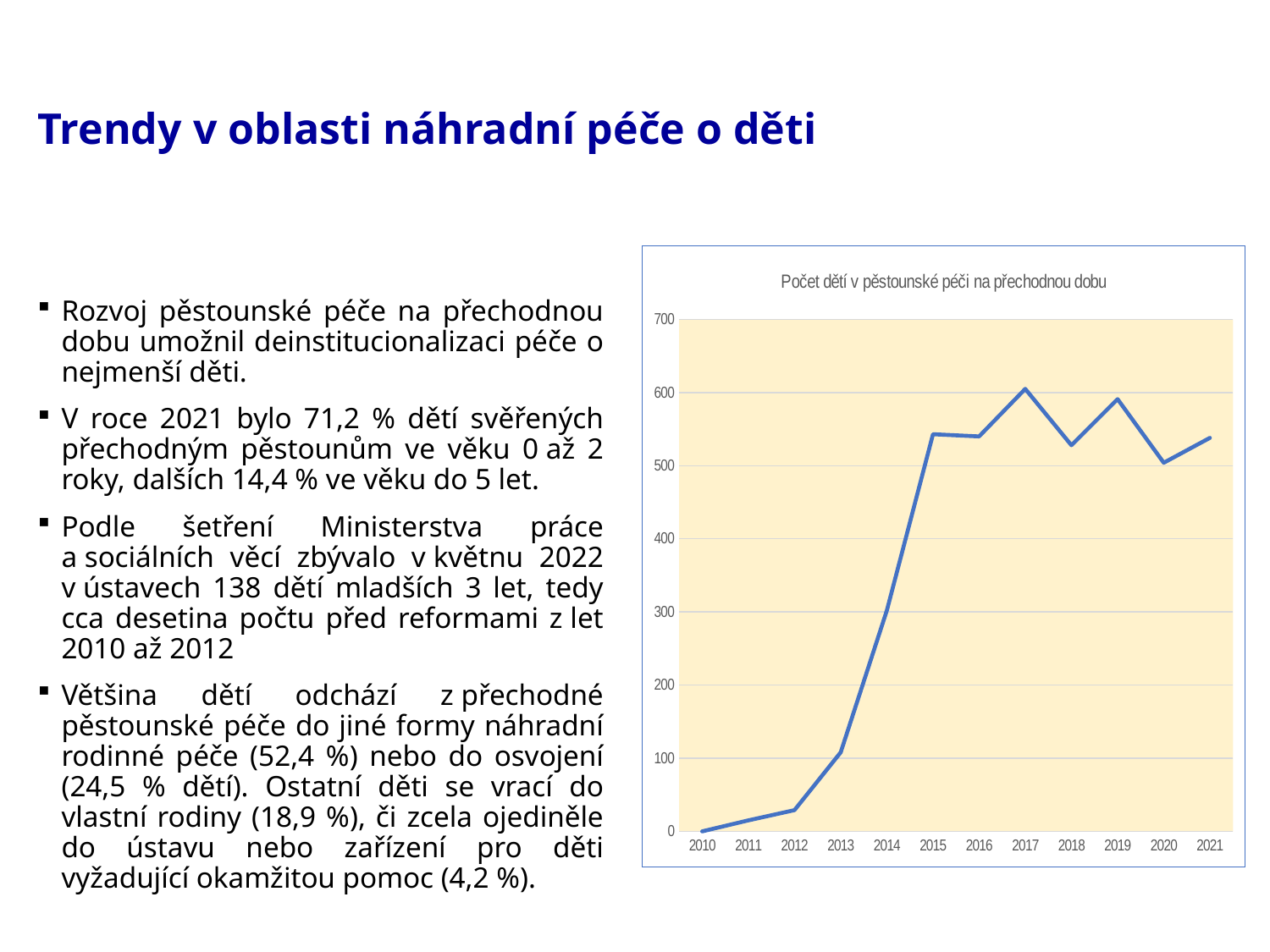
What kind of chart is shown on the slide? line chart What is the title of the chart? Počet dětí v pěstounské péči na přechodnou dobu Which year has the larger value, 2017 or 2020? 2017 How many years are plotted on the x axis of the chart? 12 Which year has the lowest value in the chart? 2010 Which year has the larger value, 2014 or 2015? 2015 Do the values rise or fall from 2010 to 2015? rise Is the value for 2014 greater or less than 400? less Is the value for 2015 greater or less than 500? greater Is the value for 2012 greater or less than 100? less Which year has the highest value in the chart? 2017